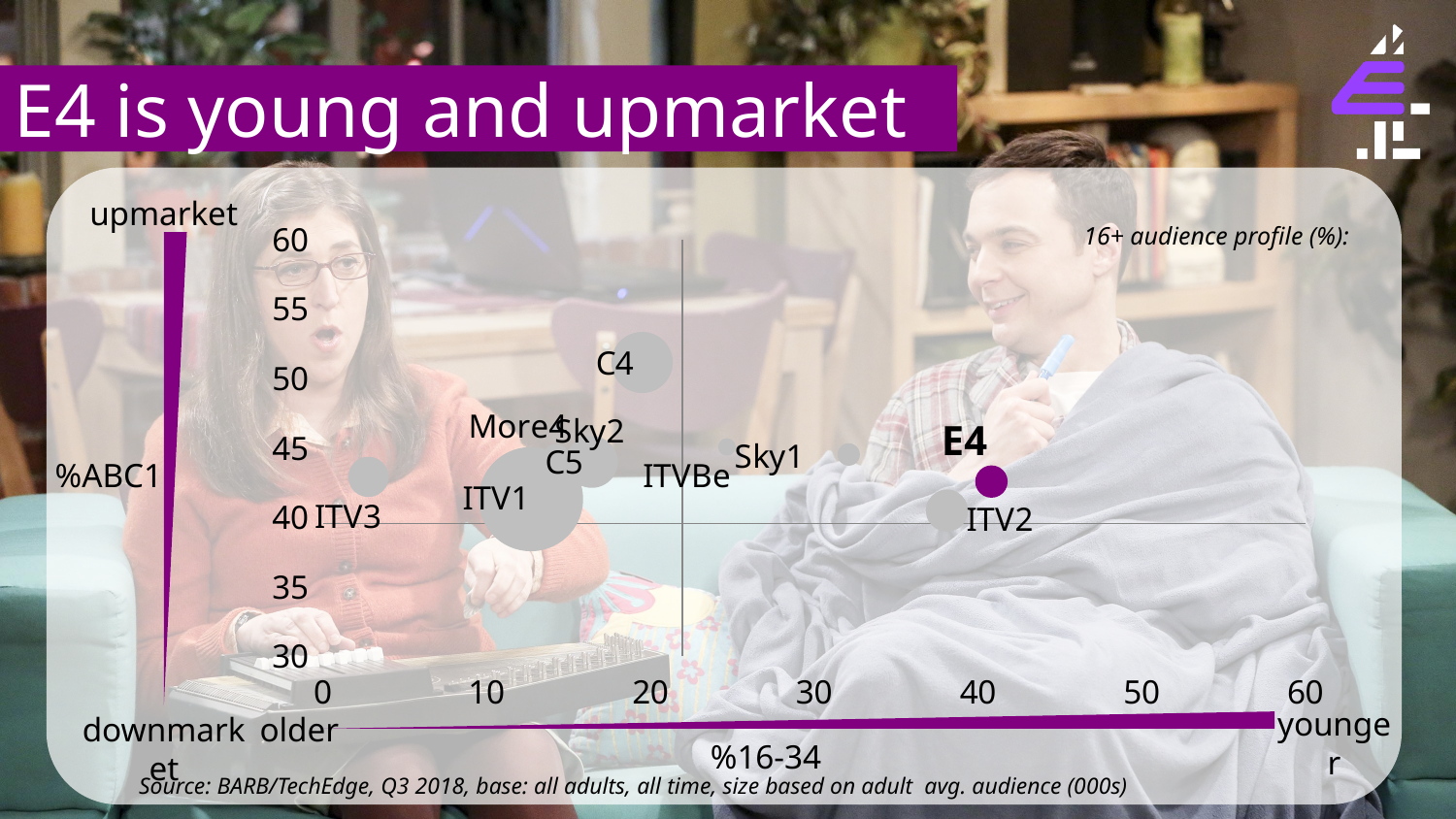
Is the %ABC1 value for C4 greater or less than 45? greater Which has the larger %16-34 value, E4 or ITV3? E4 Is the %16-34 value for E4 greater or less than 30? greater What kind of chart is shown on the slide? Bubble (scatter) chart How many channels are labelled on the chart? 10 Is the %ABC1 value for ITV2 greater or less than 45? less Which channel has the highest %16-34 value on the chart? E4 Which channel has the highest %ABC1 value on the chart? C4 Which has the larger %ABC1 value, C4 or ITV2? C4 Which channel has the lowest %16-34 value on the chart? ITV3 What is the label of the horizontal axis of the chart? %16-34